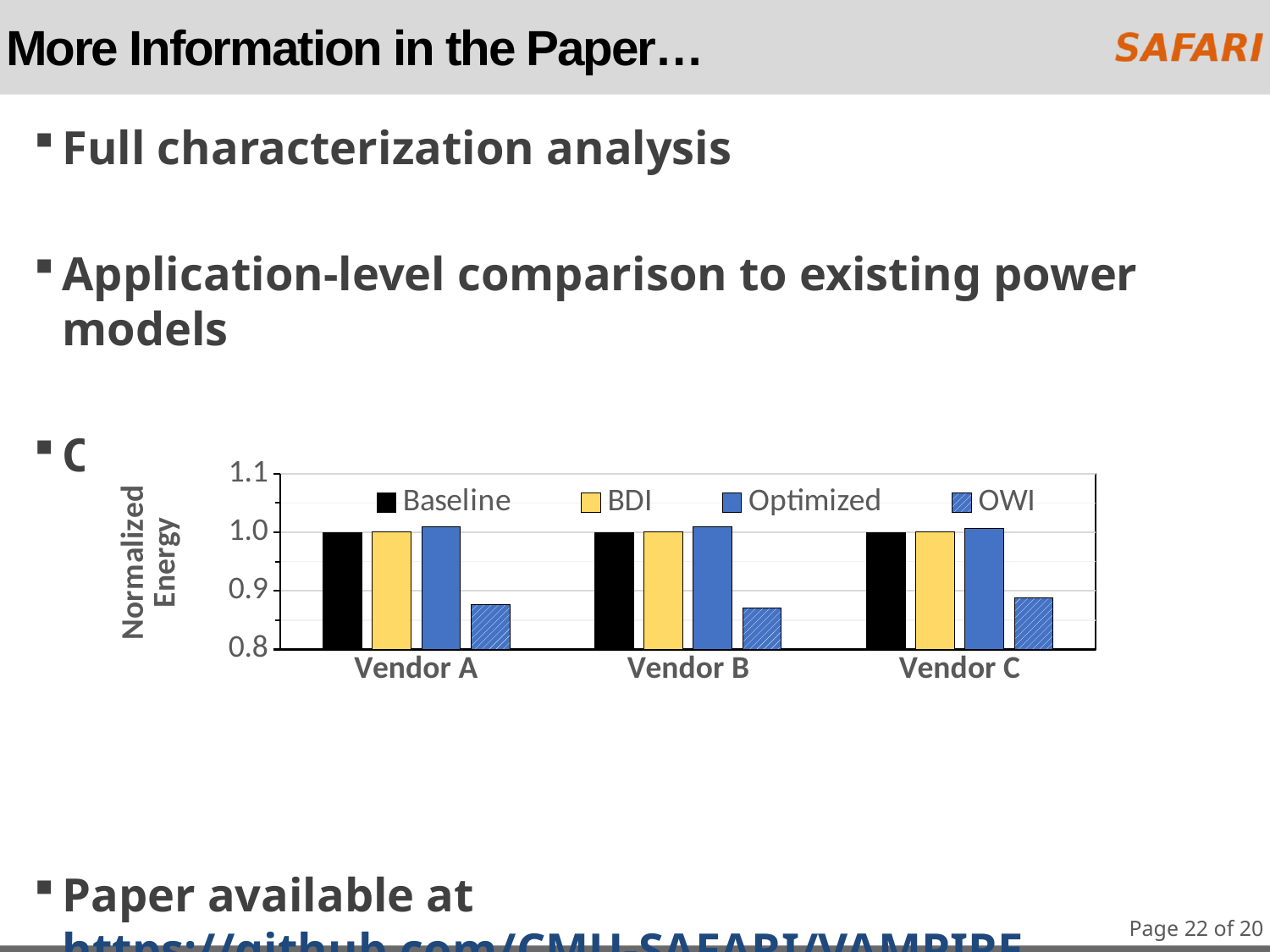
Which series has the lowest value for Vendor A? OWI Which is larger for Vendor C, the BDI value or the OWI value? BDI Is the OWI value for Vendor B greater or less than 0.9? less What kind of chart is shown on the slide? bar chart What is the label on the chart's y axis? Normalized Energy Is the OWI value for Vendor A greater or less than 0.9? less How many series does the chart's legend list? 4 Which series is drawn with hatched (striped) bars in the chart? OWI Which is larger for Vendor B, the Baseline value or the OWI value? Baseline Which series has the lowest value for Vendor B? OWI How many vendor categories are shown on the x axis? 3 Is the Optimized value for Vendor C greater or less than 0.9? greater